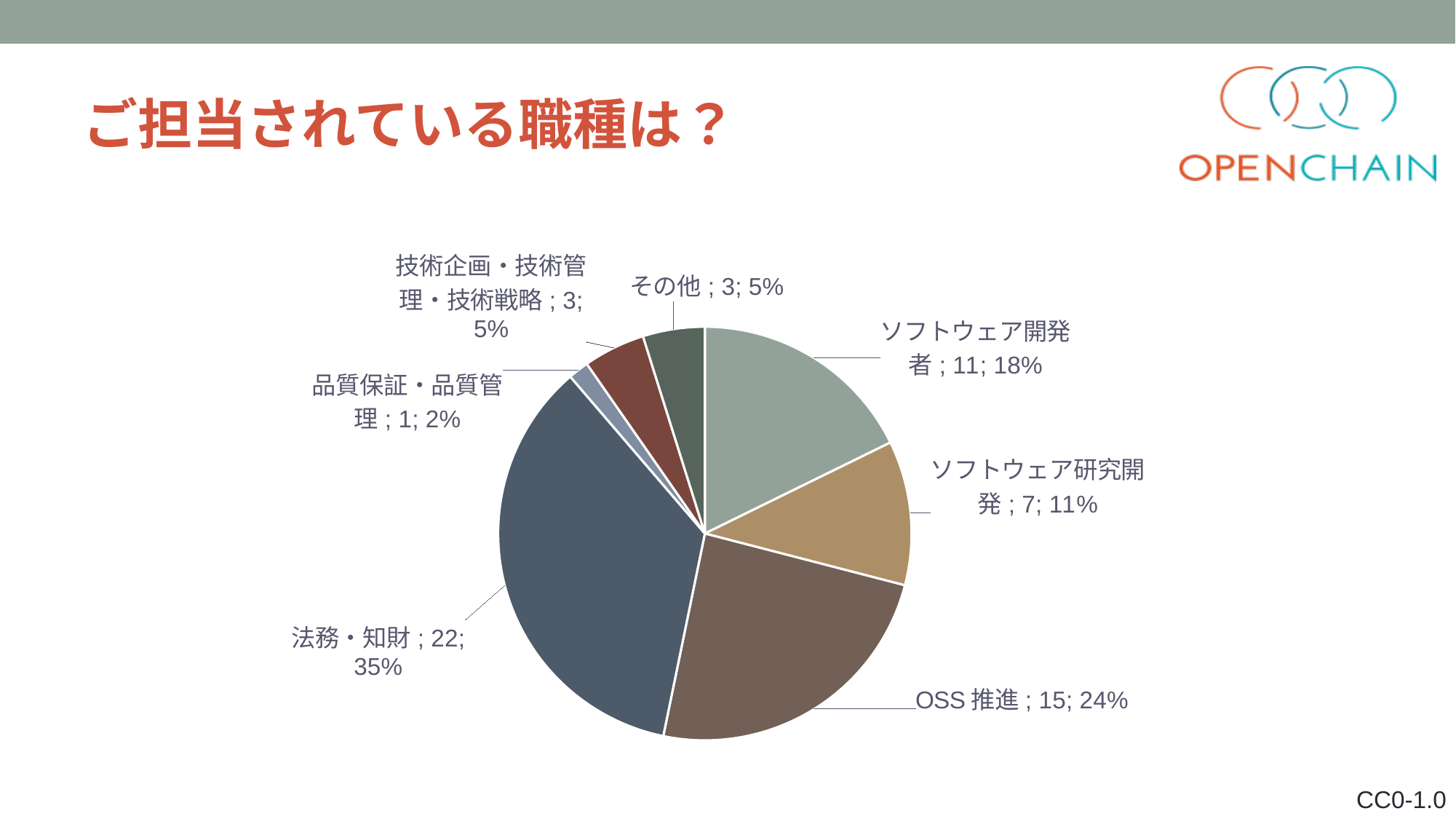
What percentage share does OSS 推進 have? 24% What is the count for 法務・知財? 22 Which is larger, ソフトウェア開発者 or ソフトウェア研究開発? ソフトウェア開発者 How many slices does the pie chart have? 7 What is the count for ソフトウェア開発者? 11 Which category has the largest slice? 法務・知財 What is the title of the slide containing the chart? ご担当されている職種は？ What is the difference in count between 法務・知財 and OSS 推進? 7 What is the total count across all slices of the pie chart? 62 What percentage share does 技術企画・技術管理・技術戦略 have? 5% What kind of chart is shown on the slide? pie chart Which category has the smallest slice? 品質保証・品質管理